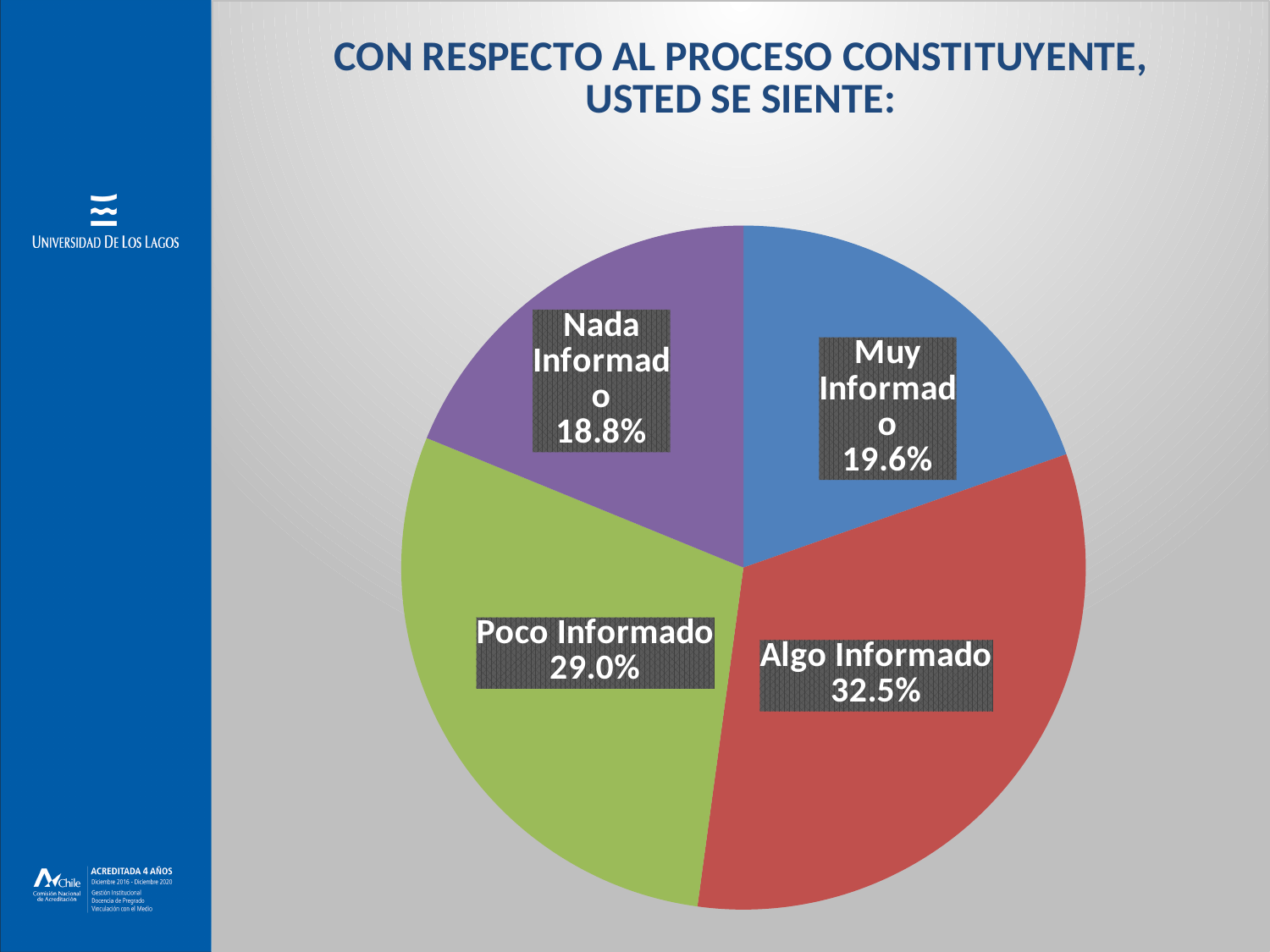
How many categories are shown in the pie chart? 4 What is the difference in percentage points between "Muy Informado" and "Nada Informado"? 0.8 Which is larger, the share for "Poco Informado" or the share for "Muy Informado"? Poco Informado What percentage of respondents said they feel "Algo Informado"? 32.5% What type of chart is shown on the slide? Pie chart What percentage of respondents said they feel "Muy Informado"? 19.6% Which category has the largest share of the pie? Algo Informado What percentage of respondents said they feel "Poco Informado"? 29.0% What is the difference in percentage points between "Algo Informado" and "Poco Informado"? 3.5 What percentage of respondents said they feel "Nada Informado"? 18.8% What colour is the "Algo Informado" slice? Red Which category has the smallest share of the pie? Nada Informado